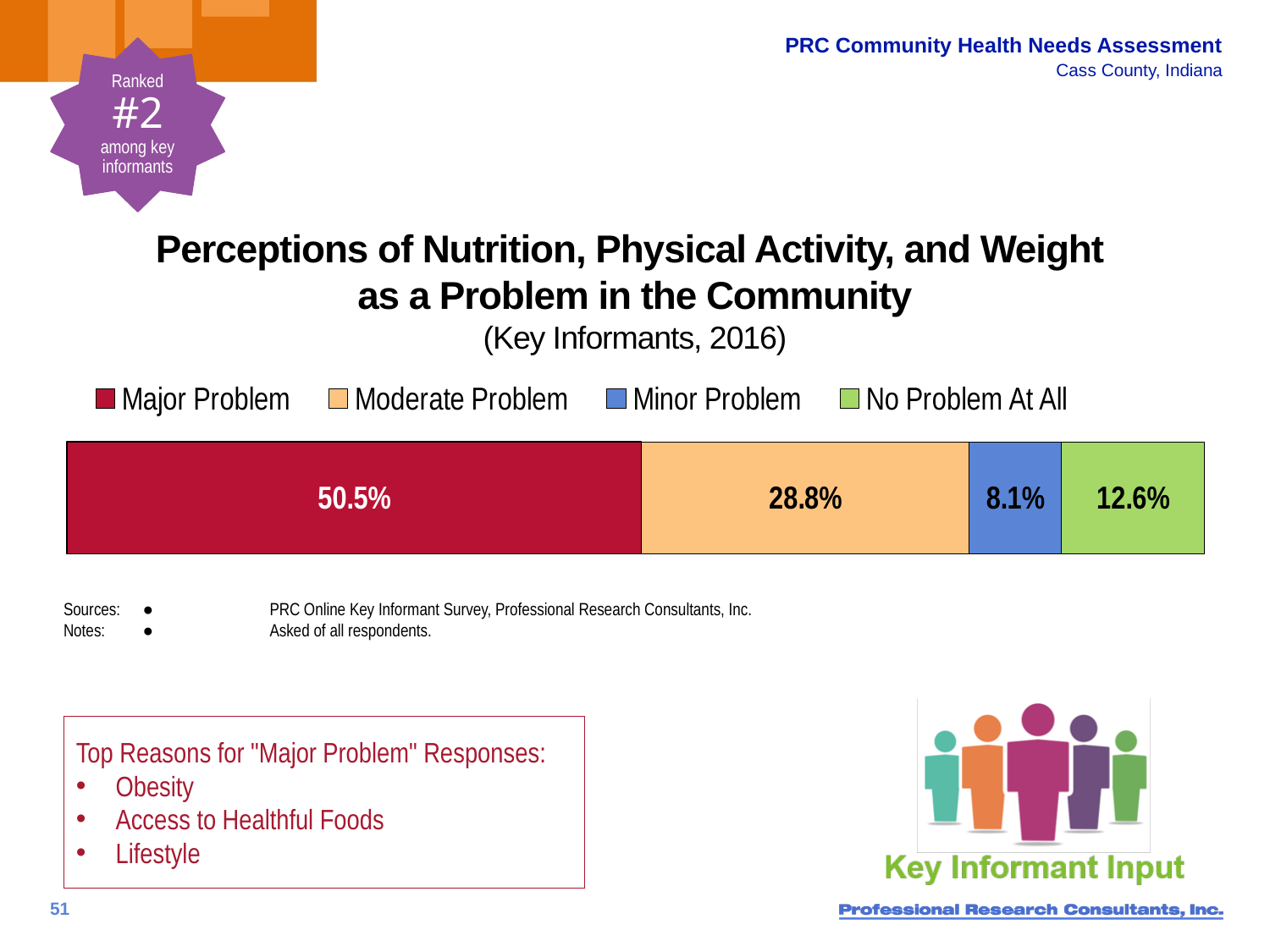
How many series does the legend list? 4 What colour represents the Major Problem segment? Red What is the difference in percentage points between Major Problem and Moderate Problem? 21.7 What percentage of key informants rated it a Moderate Problem? 28.8% What percentage of key informants said it is No Problem At All? 12.6% What kind of chart is shown on the slide? Stacked bar chart What is the combined percentage of Major Problem and Moderate Problem responses? 79.3% Which is larger, the share for No Problem At All or the share for Minor Problem? No Problem At All What percentage of key informants rated it a Minor Problem? 8.1% What percentage of key informants rated nutrition, physical activity, and weight as a Major Problem? 50.5% Which response category has the largest share? Major Problem Which response category has the smallest share? Minor Problem